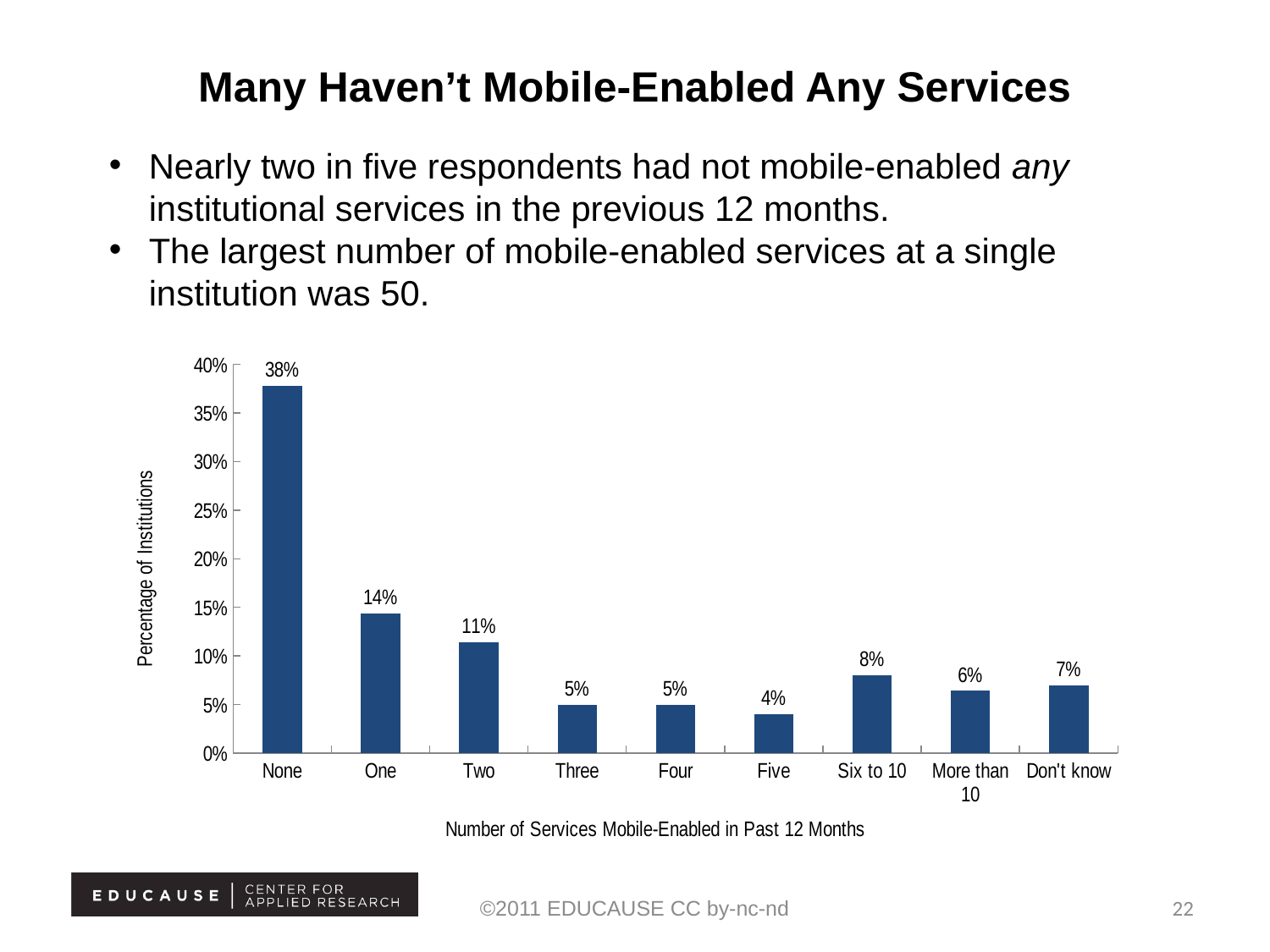
Is the value for 'One' greater or less than 10%? greater What is the label of the x axis? Number of Services Mobile-Enabled in Past 12 Months Which category has the lowest percentage of institutions? Five What percentage of institutions had mobile-enabled no services (None) in the past 12 months? 38% Which is larger, the percentage for 'Six to 10' or for 'More than 10'? Six to 10 What percentage of institutions answered 'Don't know'? 7% What is the label of the y axis? Percentage of Institutions What kind of chart is shown on the slide? Bar chart Which category has the highest percentage of institutions? None What is the difference in percentage points between the 'None' and 'One' categories? 24 What percentage of institutions mobile-enabled exactly two services? 11% How many categories are shown on the x axis? 9